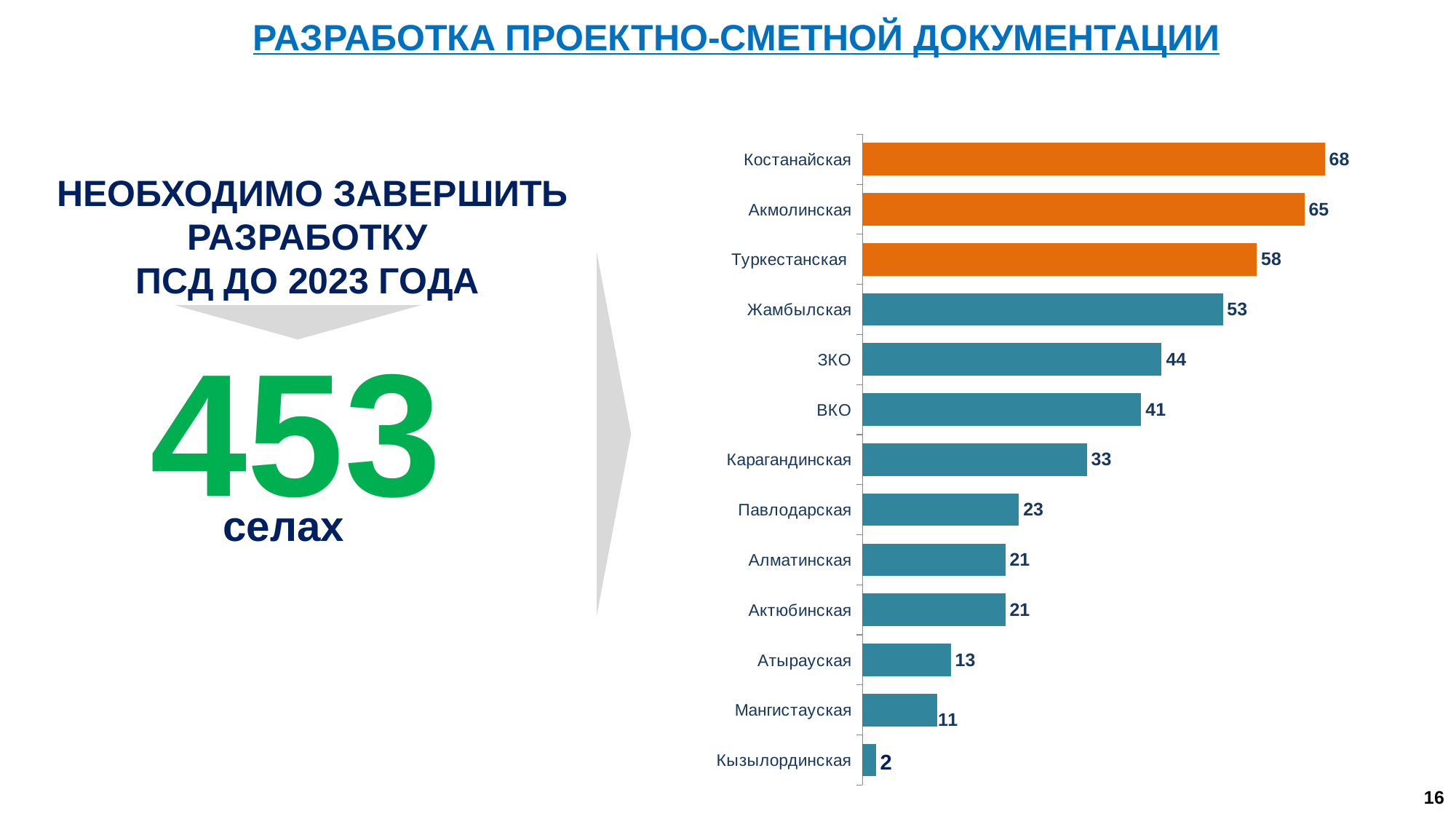
Which region has the lowest value? Кызылординская How many bars are coloured orange? 3 What is the value for Костанайская? 68 What is the difference between the values for Жамбылская and Павлодарская? 30 What is the value for Мангистауская? 11 What is the value for Карагандинская? 33 What kind of chart is shown on the slide? bar chart Which region has the highest value? Костанайская How many regions are shown in the chart? 13 What is the difference between the values for Костанайская and Акмолинская? 3 Which is larger, the value for ЗКО or the value for ВКО? ЗКО Which two regions have the same value of 21? Алматинская and Актюбинская